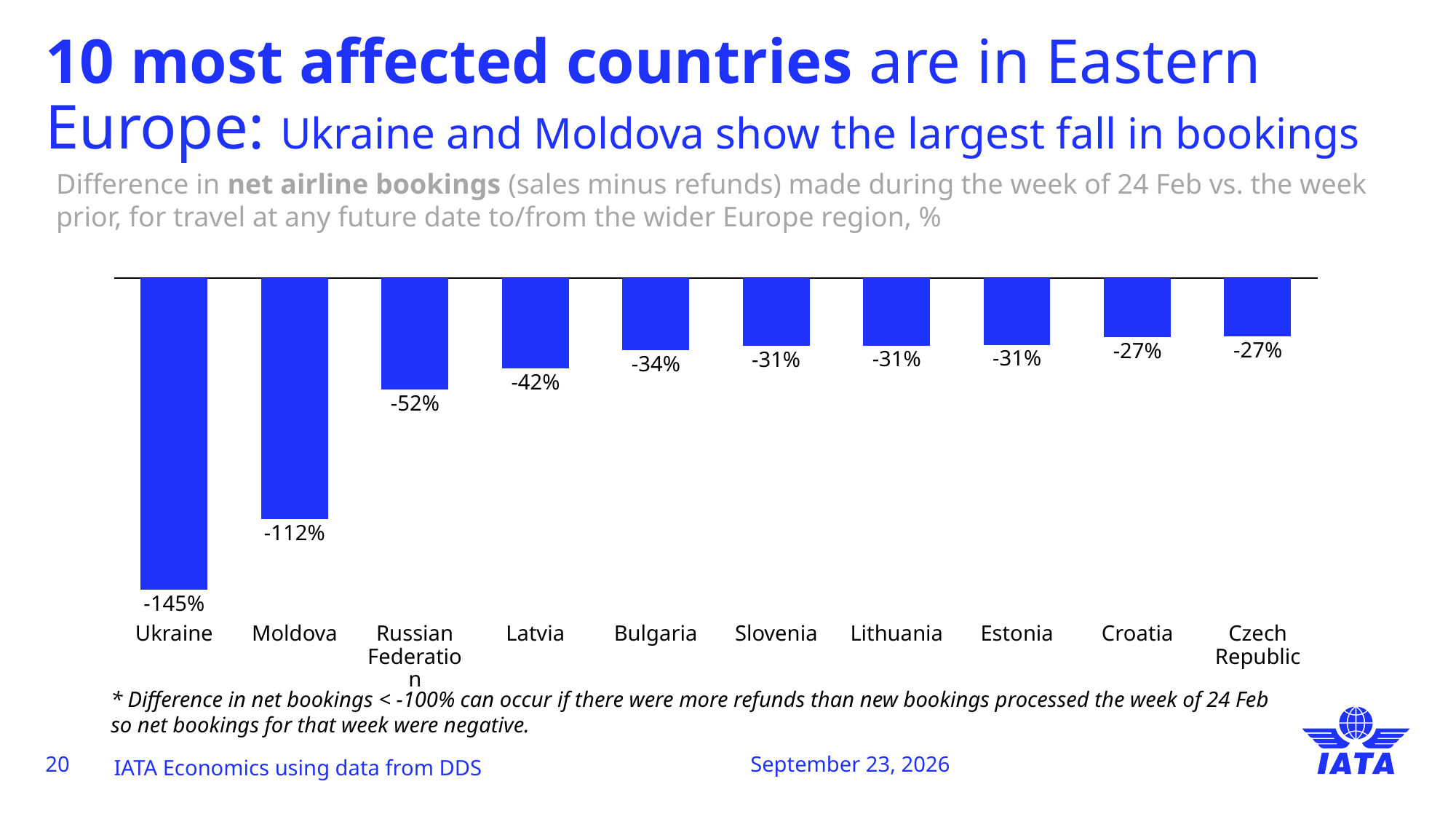
Which country shows a larger fall in bookings, Latvia or Estonia? Latvia What is the value shown for Ukraine? -145% How many countries are shown in the chart? 10 What type of chart is shown on the slide? Bar chart What is the value shown for the Russian Federation? -52% What is the difference between the values for Ukraine and Moldova? 33 percentage points Which country has the smallest decline among those shown, excluding ties? Name the two countries tied at -27%. Croatia and Czech Republic What is the value shown for Bulgaria? -34% Which country shows the largest fall in net airline bookings? Ukraine Do the values become less negative or more negative moving from left to right along the x axis? Less negative What is the difference between the values for Latvia and Bulgaria? 8 percentage points What is the value shown for Moldova? -112%